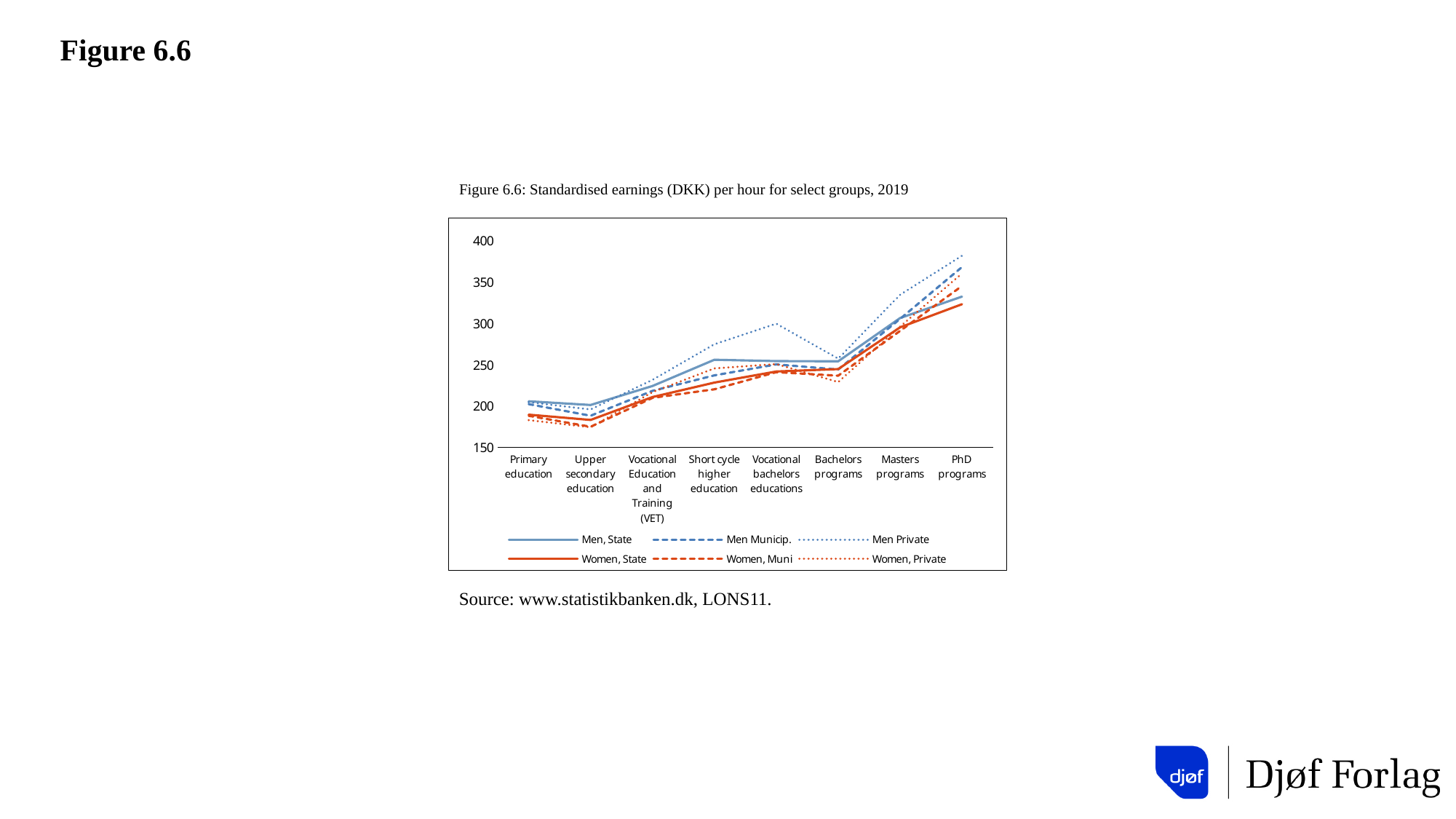
Is the value for Women, State at Primary education greater or less than 200? less How many series does the legend list? 6 Is the value for Men Private at PhD programs greater or less than 350? greater At Vocational bachelors educations, which is larger: Men Private or Men, State? Men Private What kind of chart is shown on the slide? line chart What is the title of the chart? Figure 6.6: Standardised earnings (DKK) per hour for select groups, 2019 Which series has the highest value at PhD programs? Men Private For the Men Private series, which category has the highest value? PhD programs Is the value for Women, State at PhD programs greater or less than 300? greater How many education categories are shown on the x axis? 8 Which series is shown with a solid orange line in the legend? Women, State